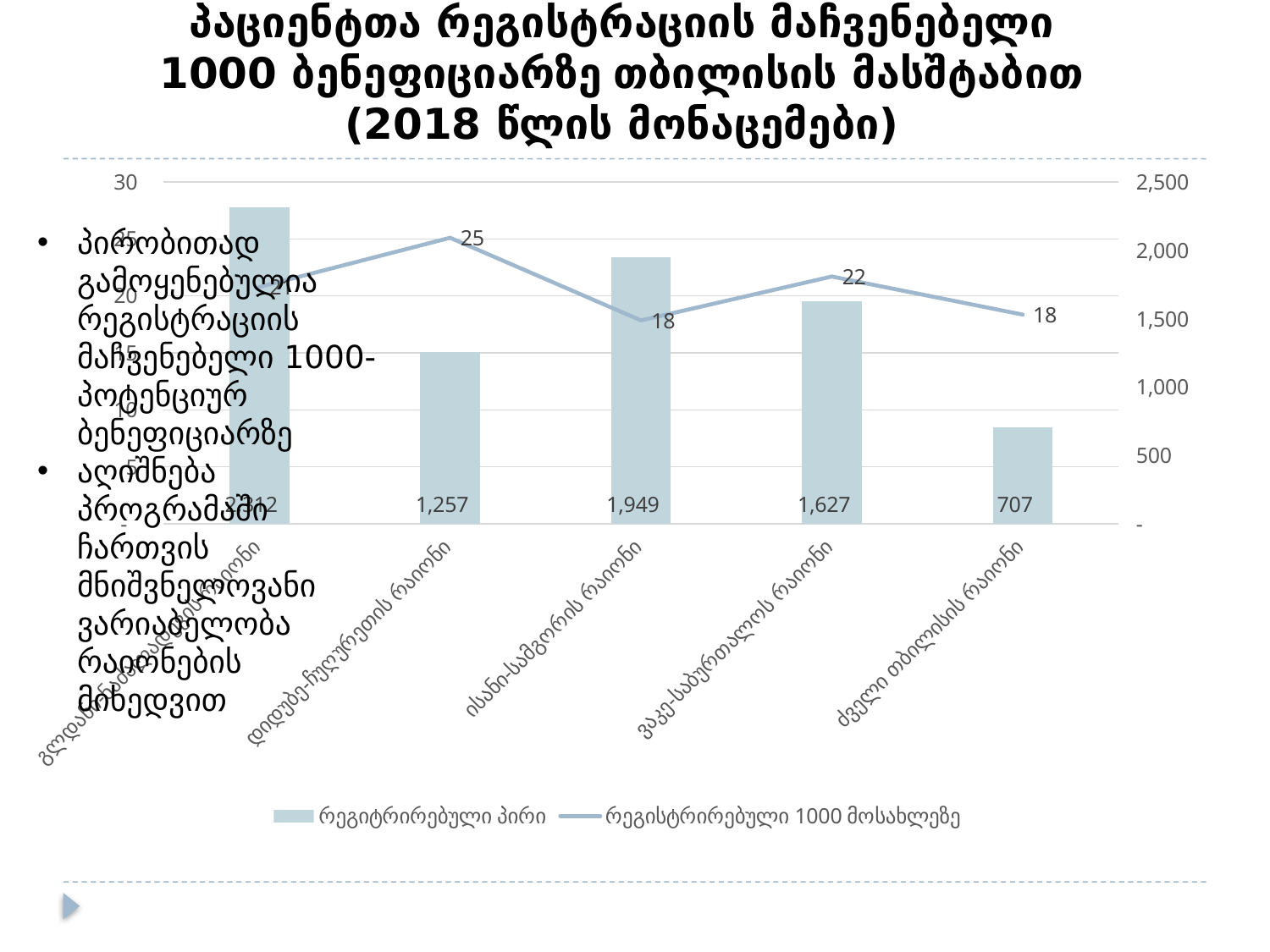
What is the value of რეგიტრირებული პირი for დიდუბე-ჩუღურეთის რაიონი? 1,257 What is the value of რეგიტრირებული პირი for ძველი თბილისის რაიონი? 707 What is the value of რეგისტრირებული 1000 მოსახლეზე for ვაკე-საბურთალოს რაიონი? 22 What is the value of რეგიტრირებული პირი for ვაკე-საბურთალოს რაიონი? 1,627 Which district has the highest value of რეგისტრირებული 1000 მოსახლეზე? დიდუბე-ჩუღურეთის რაიონი Which district has the lowest value of რეგიტრირებული პირი? ძველი თბილისის რაიონი What is the value of რეგისტრირებული 1000 მოსახლეზე for დიდუბე-ჩუღურეთის რაიონი? 25 How many series does the legend list? 2 What is the difference in რეგიტრირებული პირი between ისანი-სამგორის რაიონი and ვაკე-საბურთალოს რაიონი? 322 What kind of chart is shown on the slide? Combination bar and line chart What is the value of რეგიტრირებული პირი for ისანი-სამგორის რაიონი? 1,949 Which has a larger value of რეგიტრირებული პირი: ისანი-სამგორის რაიონი or დიდუბე-ჩუღურეთის რაიონი? ისანი-სამგორის რაიონი